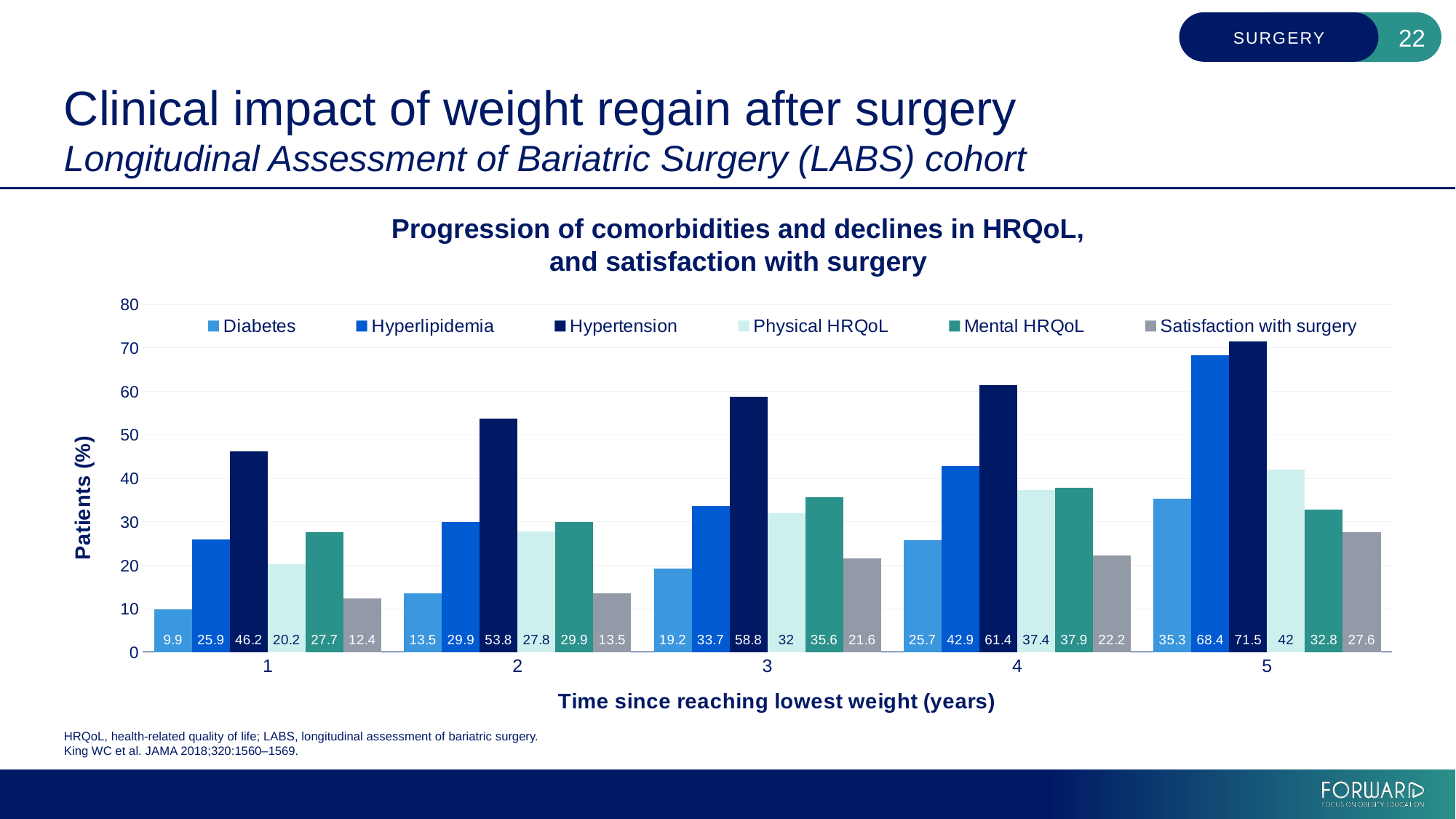
Do the Diabetes values rise or fall from year 1 to year 5? Rise Which series has the highest value at year 5? Hypertension Which series has the lowest value at year 1? Diabetes What is the value for Hypertension at year 3? 58.8 What is the value for Satisfaction with surgery at year 5? 27.6 Is the value for Hyperlipidemia at year 5 greater or less than 60? greater What is the difference between the Hypertension values at year 5 and year 1? 25.3 What kind of chart is shown? Bar chart How many time points are shown on the x axis? 5 What is the value for Diabetes at year 1? 9.9 Which is larger at year 4: Physical HRQoL or Mental HRQoL? Mental HRQoL How many series does the legend list? 6